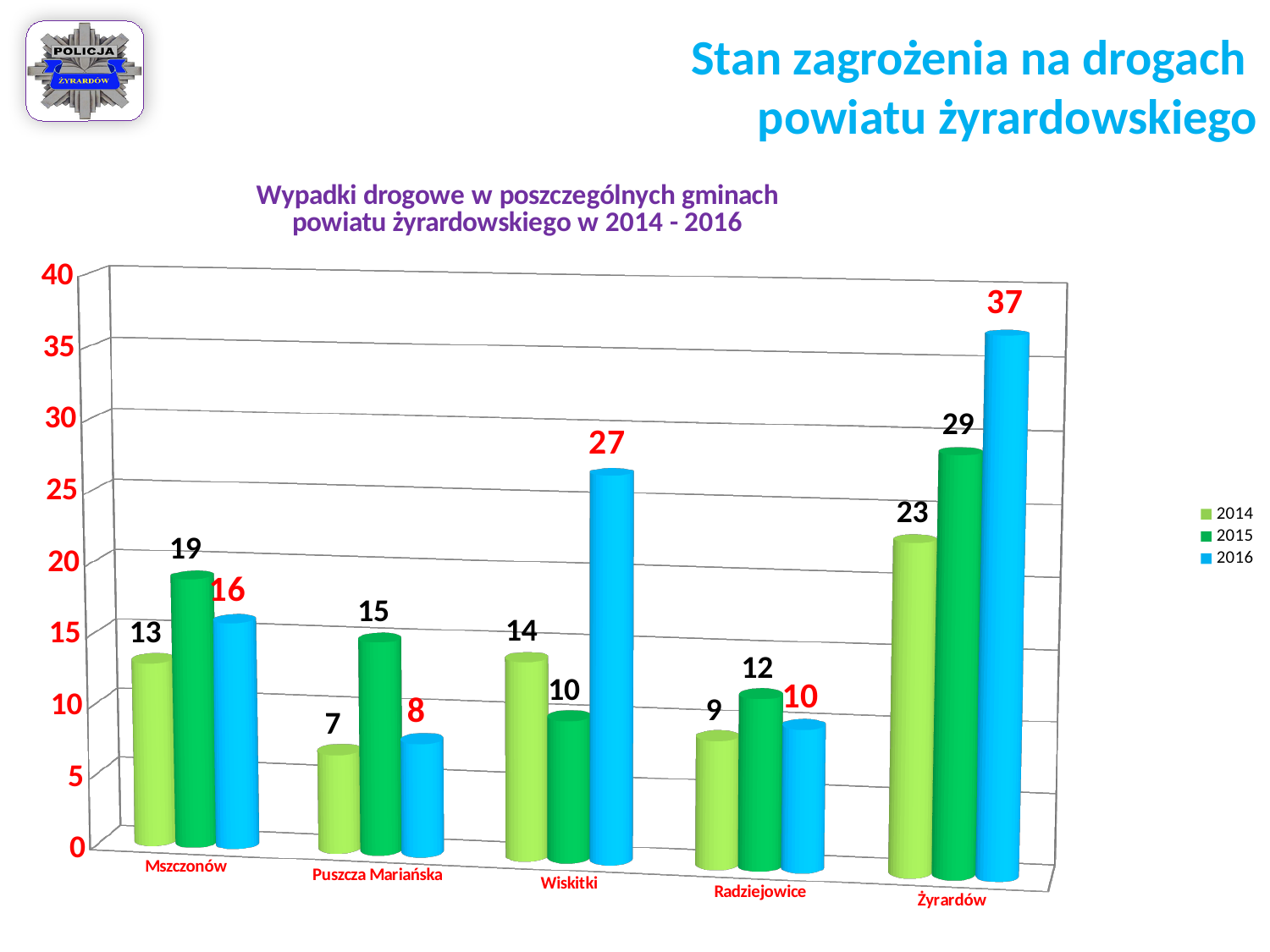
How many gminas are shown on the x axis? 5 Which is larger for Mszczonów: the 2015 value or the 2016 value? 2015 Is the value for Żyrardów in 2015 greater or less than 25? greater How many series does the legend list? 3 What is the value for Żyrardów in 2016? 37 What is the value for Puszcza Mariańska in 2014? 7 Which gmina has the highest value in 2016? Żyrardów What is the difference between the 2016 and 2015 values for Wiskitki? 17 Which gmina has the lowest value in 2014? Puszcza Mariańska Do the values for Żyrardów rise or fall from 2014 to 2016? rise What kind of chart is shown? bar chart What is the value for Wiskitki in 2015? 10